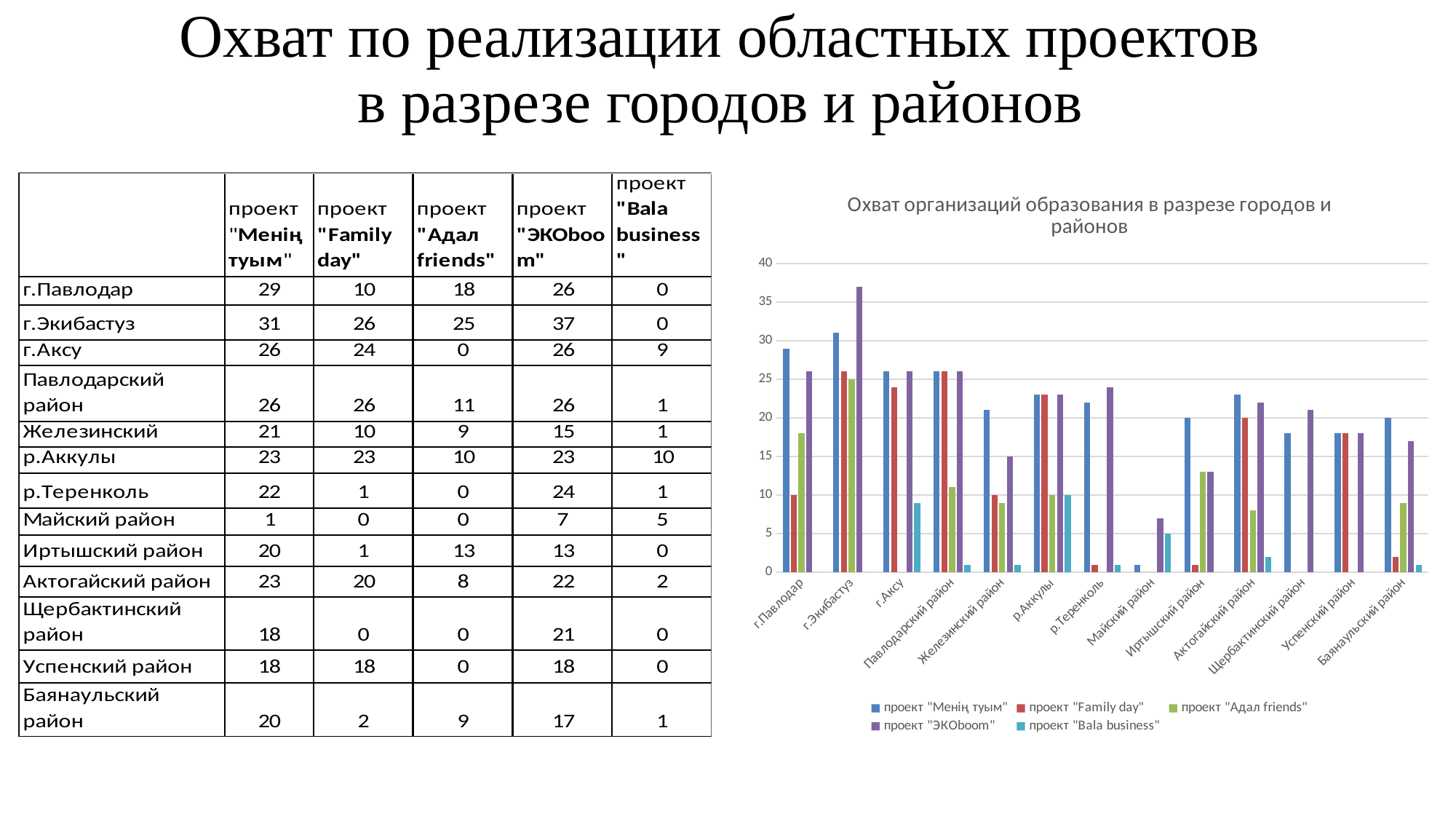
What kind of chart is shown on the slide? bar chart Which city or district has the highest value for проект "ЭКОboom"? г.Экибастуз Is the value for проект "ЭКОboom" in Майский район greater or less than 10? less What is the value for проект "Менің туым" in г.Павлодар? 29 In г.Павлодар, which is larger: проект "Менің туым" or проект "Family day"? проект "Менің туым" Which city or district has the lowest value for проект "Менің туым"? Майский район How many cities/districts are shown along the x axis of the chart? 13 How many series does the chart legend list? 5 What is the value for проект "ЭКОboom" in г.Экибастуз? 37 What is the difference between the проект "ЭКОboom" values for г.Экибастуз and г.Павлодар? 11 What is the title of the chart? Охват организаций образования в разрезе городов и районов Is the value for проект "ЭКОboom" in г.Экибастуз greater or less than 35? greater